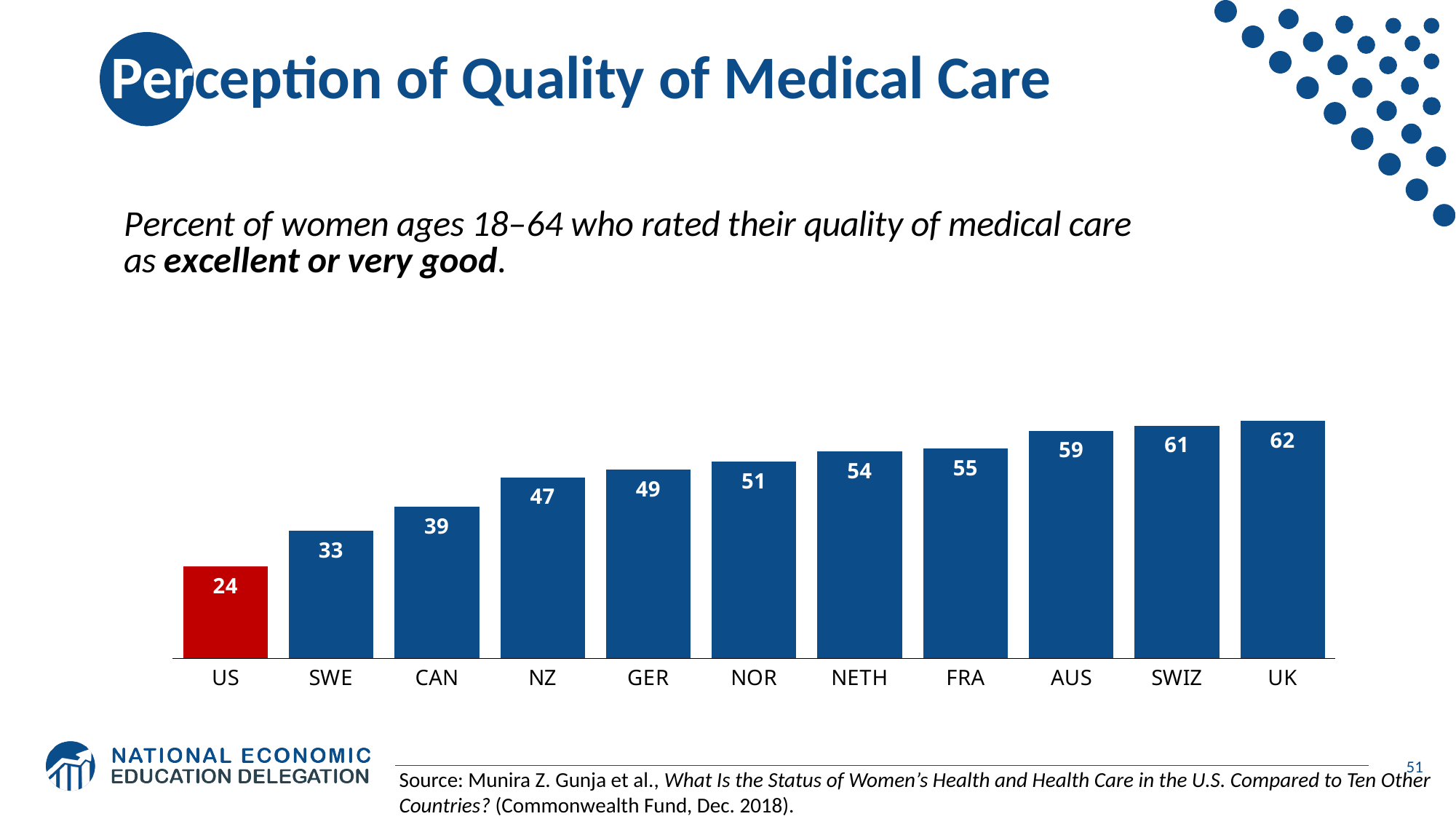
Which is larger, the value for SWE or the value for NZ? NZ Do the values rise or fall from left to right across the x axis? rise Which country has the highest value? UK What is the difference between the values for UK and US? 38 Which bar is coloured differently from the others? US What is the value for AUS? 59 What kind of chart is shown on the slide? bar chart What is the value for GER? 49 Which country has the lowest value? US What is the value for the US? 24 What is the difference between the values for NETH and CAN? 15 How many countries are shown in the chart? 11